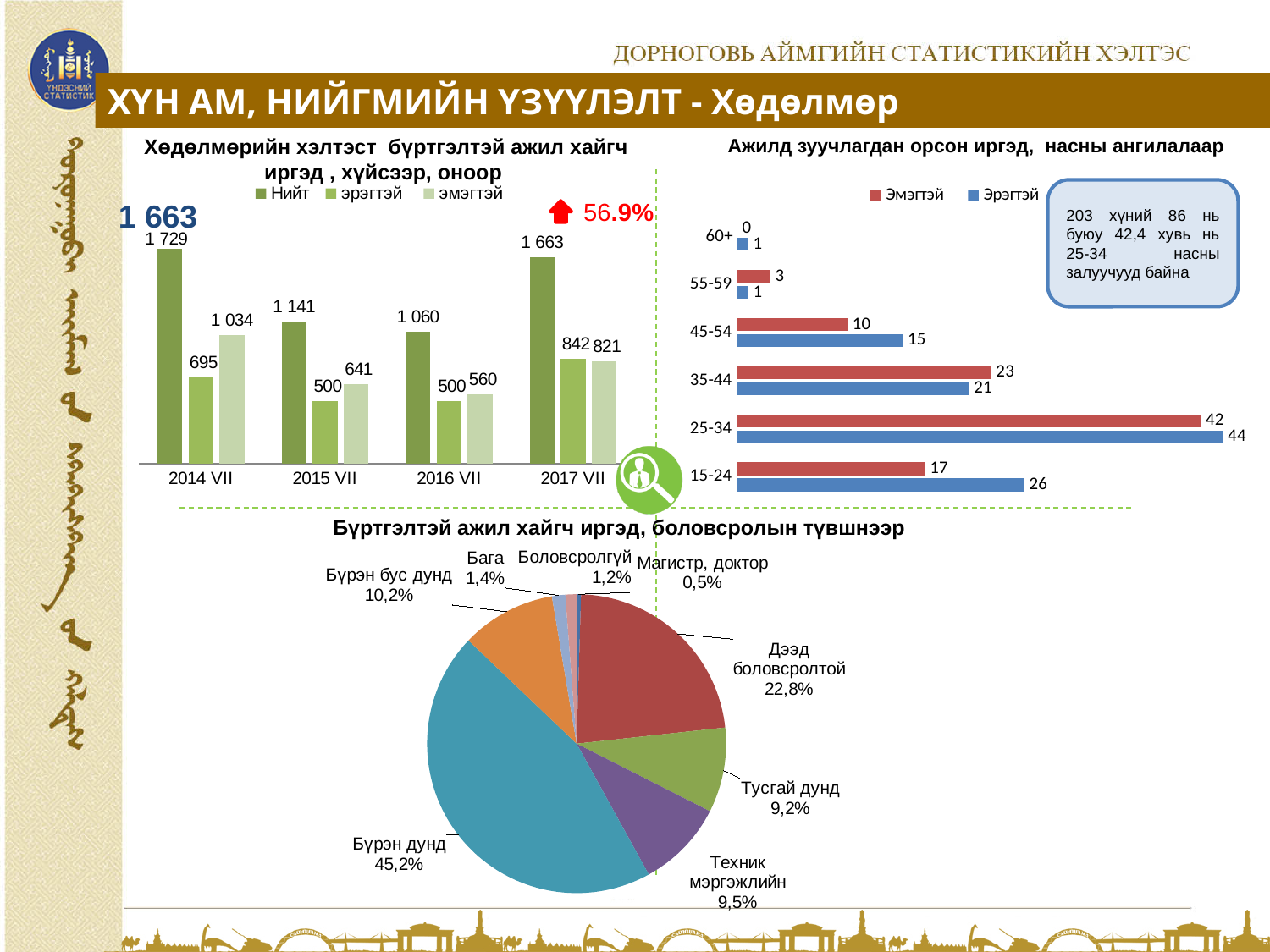
In the top-right chart, is the Эмэгтэй value for 35-44 larger or smaller than the Эрэгтэй value for 35-44? larger In the top-right chart, which age group has the lowest Эмэгтэй value? 60+ What type of chart is the bottom chart 'Бүртгэлтэй ажил хайгч иргэд, боловсролын түвшнээр'? pie chart In the top-right chart 'Ажилд зуучлагдан орсон иргэд, насны ангилалаар', what is the Эрэгтэй value for the 25-34 age group? 44 In the top-left chart 'Хөдөлмөрийн хэлтэст бүртгэлтэй ажил хайгч иргэд, хүйсээр, оноор', what is the Нийт value for 2017 VII? 1 663 In the top-left chart, which year has the highest Нийт value? 2014 VII In the top-left chart, what is the difference between the Нийт values for 2014 VII and 2017 VII? 66 In the top-right chart, what is the Эмэгтэй value for the 15-24 age group? 17 In the top-left chart, how many series does the legend list? 3 In the top-left chart, what is the эмэгтэй value for 2014 VII? 1 034 In the bottom pie chart 'Бүртгэлтэй ажил хайгч иргэд, боловсролын түвшнээр', what share does Бүрэн дунд have? 45,2% In the top-right chart, how many age groups are shown? 6